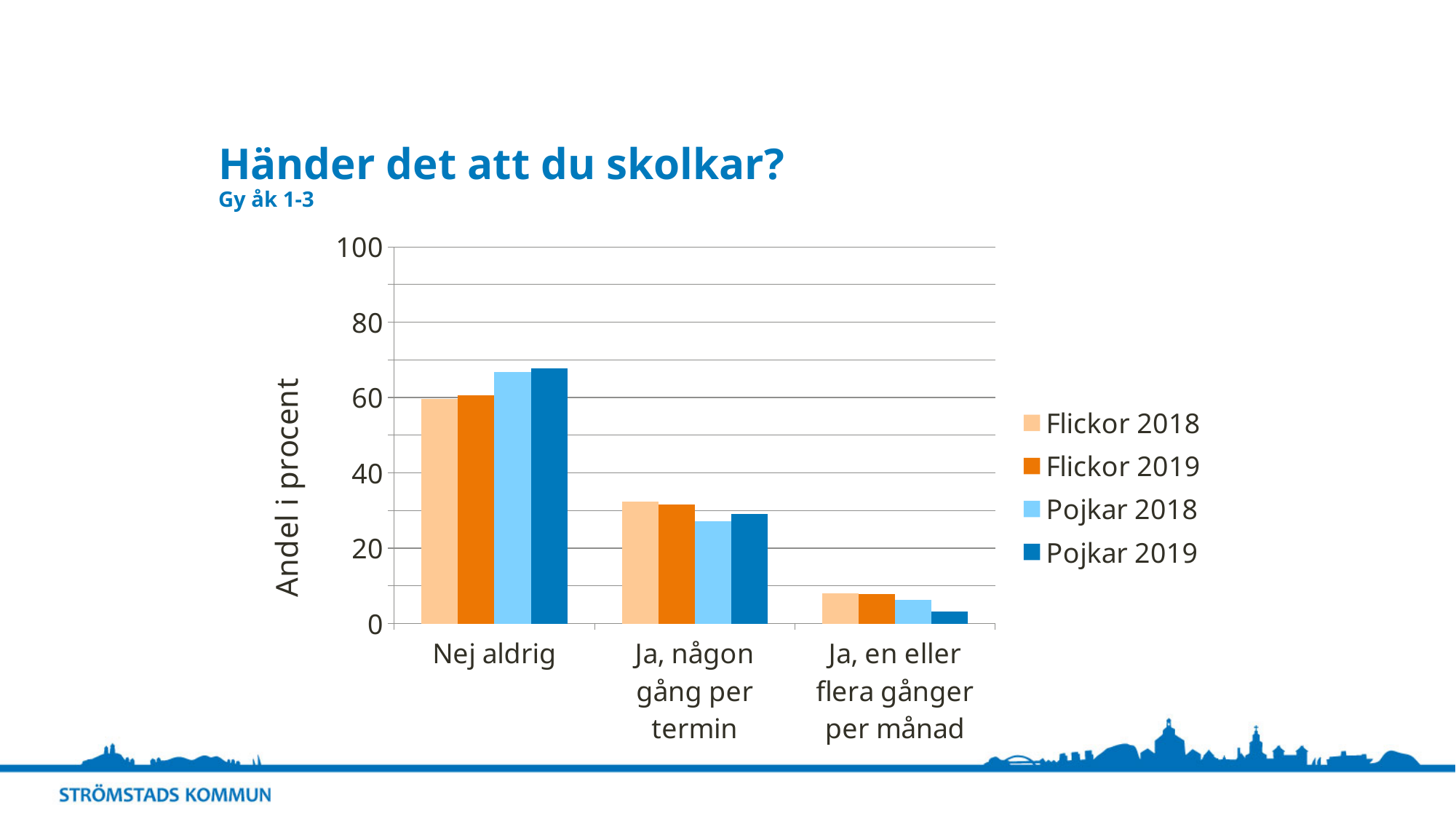
Is the value for Flickor 2018 in the "Nej aldrig" category greater or less than 80? less Is the value for Flickor 2018 in the "Ja, någon gång per termin" category greater or less than 20? greater Do the values for Flickor 2018 rise or fall from left to right along the x axis? Fall For the Pojkar 2019 series, which category has the highest value? Nej aldrig In the "Nej aldrig" category, which is larger: Flickor 2018 or Pojkar 2018? Pojkar 2018 For the Flickor 2019 series, which category has the lowest value? Ja, en eller flera gånger per månad What kind of chart is shown on the slide? Bar chart Is the value for Pojkar 2019 in the "Nej aldrig" category greater or less than 60? greater What is the title of the y axis? Andel i procent How many series does the legend list? 4 How many categories are shown on the x axis? 3